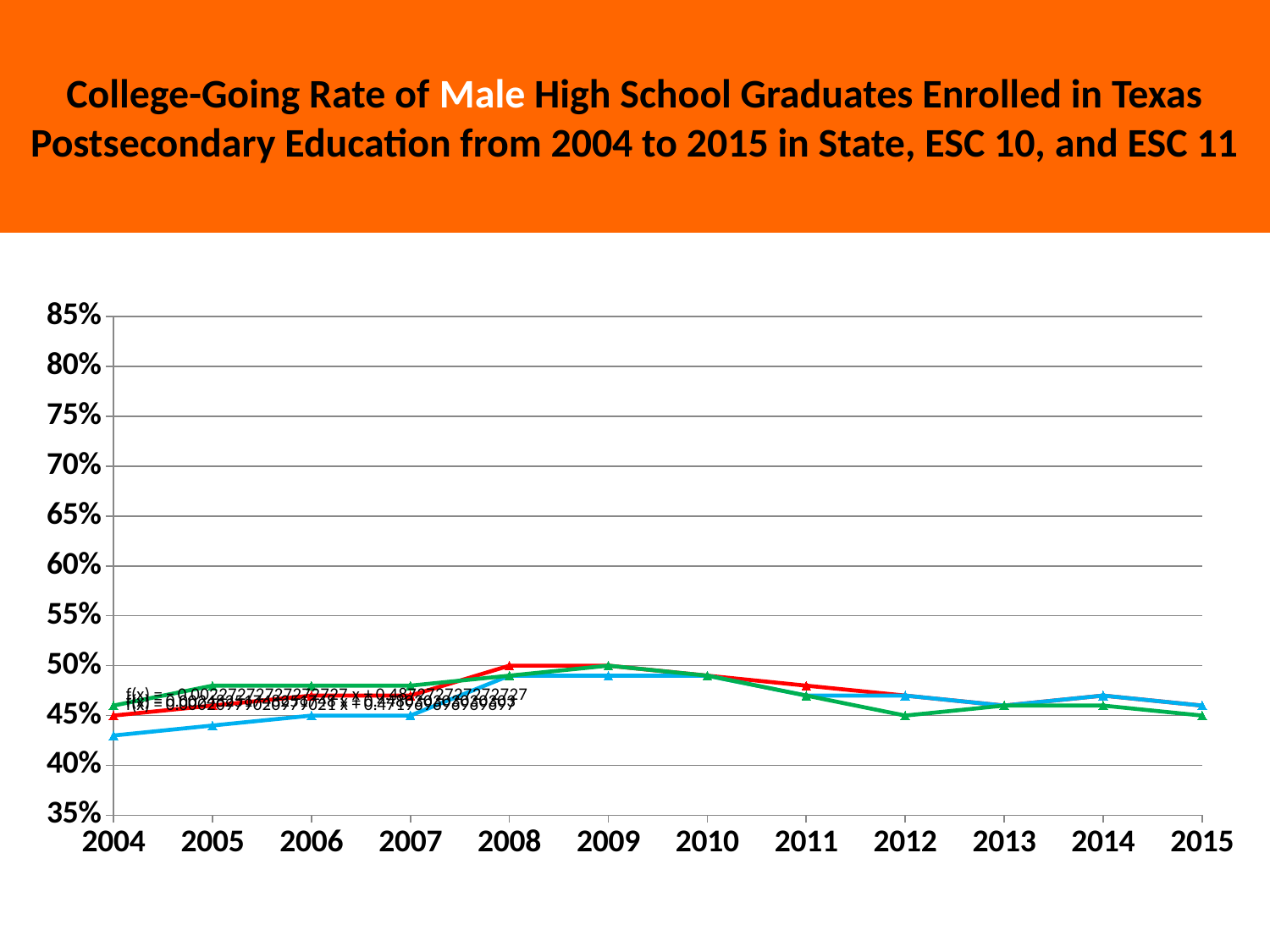
How many lines are plotted on the chart? 3 Is the value of the blue line in 2014 greater or less than 50%? less In 2012, which line has the higher value, the green line or the blue line? blue line In 2004, which line has the higher value, the red line or the blue line? red line Is the value of the red line in 2011 greater or less than 45%? greater Does the blue line rise or fall from 2004 to 2009? rise Is the value of the green line in 2005 greater or less than 45%? greater What kind of chart is shown on the slide? line chart How many years are shown along the x axis of the chart? 12 What is the highest value shown on the chart's y axis? 85% In which year is the blue line at its lowest value? 2004